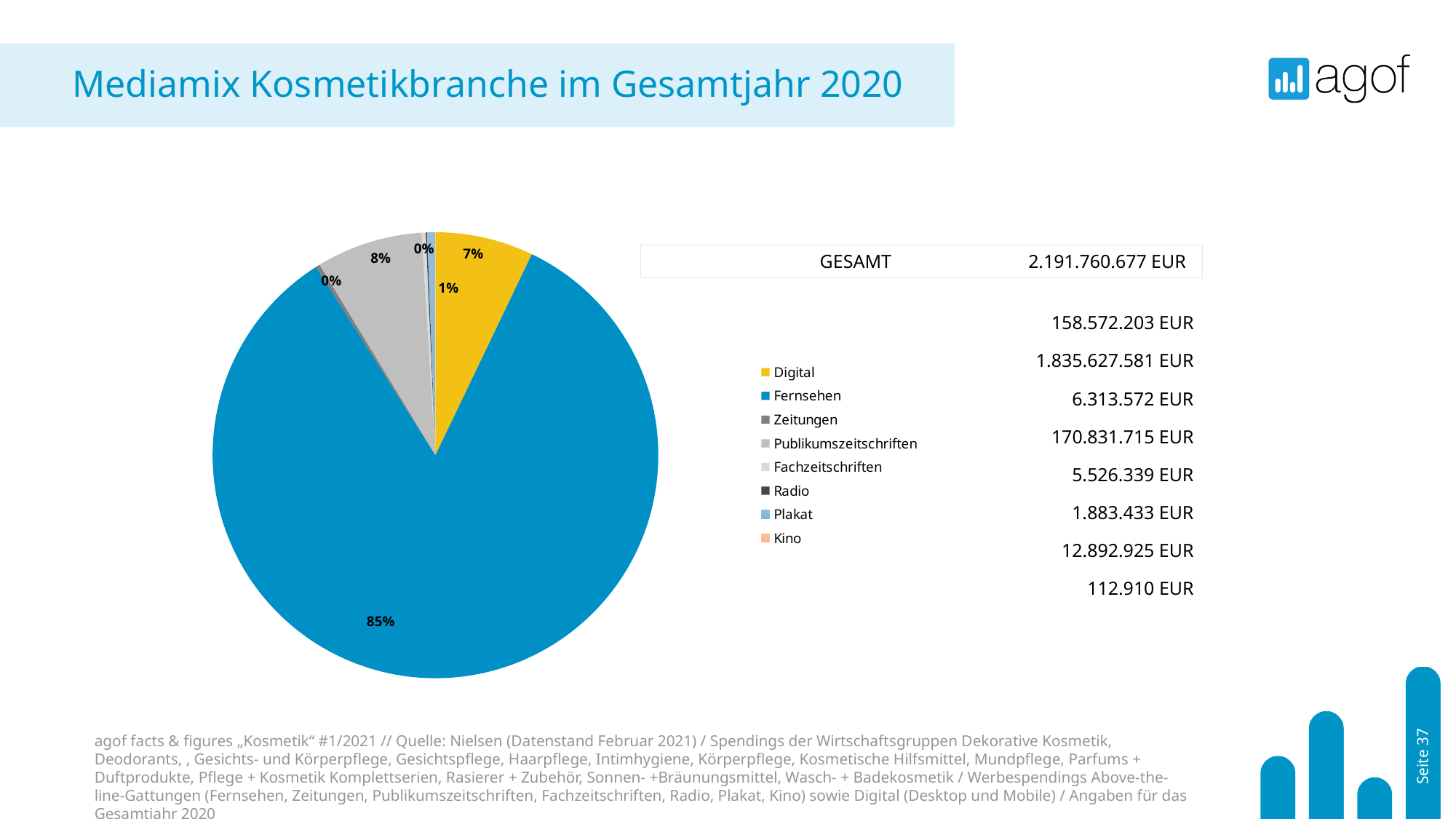
What share of the pie does Fernsehen have? 85% Which category has the largest slice of the pie? Fernsehen What share of the pie does Publikumszeitschriften have? 8% How many categories does the legend list? 8 Which colour represents Digital in the pie chart? yellow Which is larger, the share for Digital or the share for Publikumszeitschriften? Publikumszeitschriften What is the difference in percentage points between the Fernsehen share and the Publikumszeitschriften share? 77 What kind of chart is shown on the slide? pie chart What is the GESAMT value shown next to the chart? 2.191.760.677 EUR What share of the pie does Digital have? 7% Is the share for Fernsehen greater or less than 50%? greater What is the title of the slide containing the chart? Mediamix Kosmetikbranche im Gesamtjahr 2020